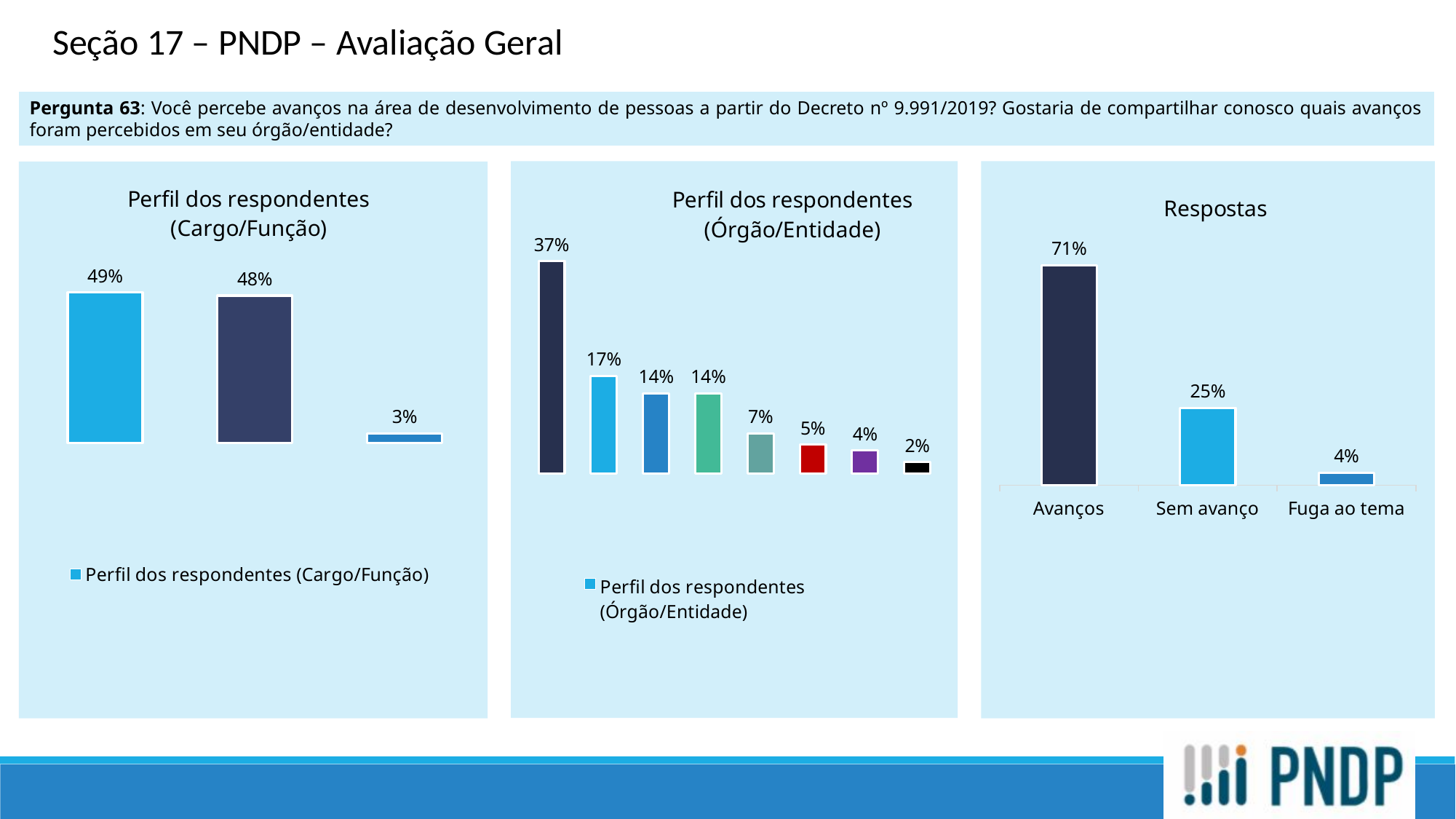
In the 'Respostas' chart, what is the value for Fuga ao tema? 4% In the 'Perfil dos respondentes (Órgão/Entidade)' chart, how many bars are shown? 8 In the 'Respostas' chart, which is larger: Sem avanço or Fuga ao tema? Sem avanço In the 'Respostas' chart, which category has the lowest value? Fuga ao tema In the 'Respostas' chart, what is the difference between the values for Avanços and Sem avanço? 46% In the 'Respostas' chart, which category has the highest value? Avanços What kind of chart is the 'Respostas' chart? Bar chart In the 'Perfil dos respondentes (Cargo/Função)' chart, what is the value of the smallest bar? 3% In the 'Respostas' chart, what is the value for Avanços? 71% In the 'Respostas' chart, how many categories are shown? 3 In the 'Respostas' chart, what is the value for Sem avanço? 25% In the 'Perfil dos respondentes (Órgão/Entidade)' chart, what is the value of the tallest bar? 37%